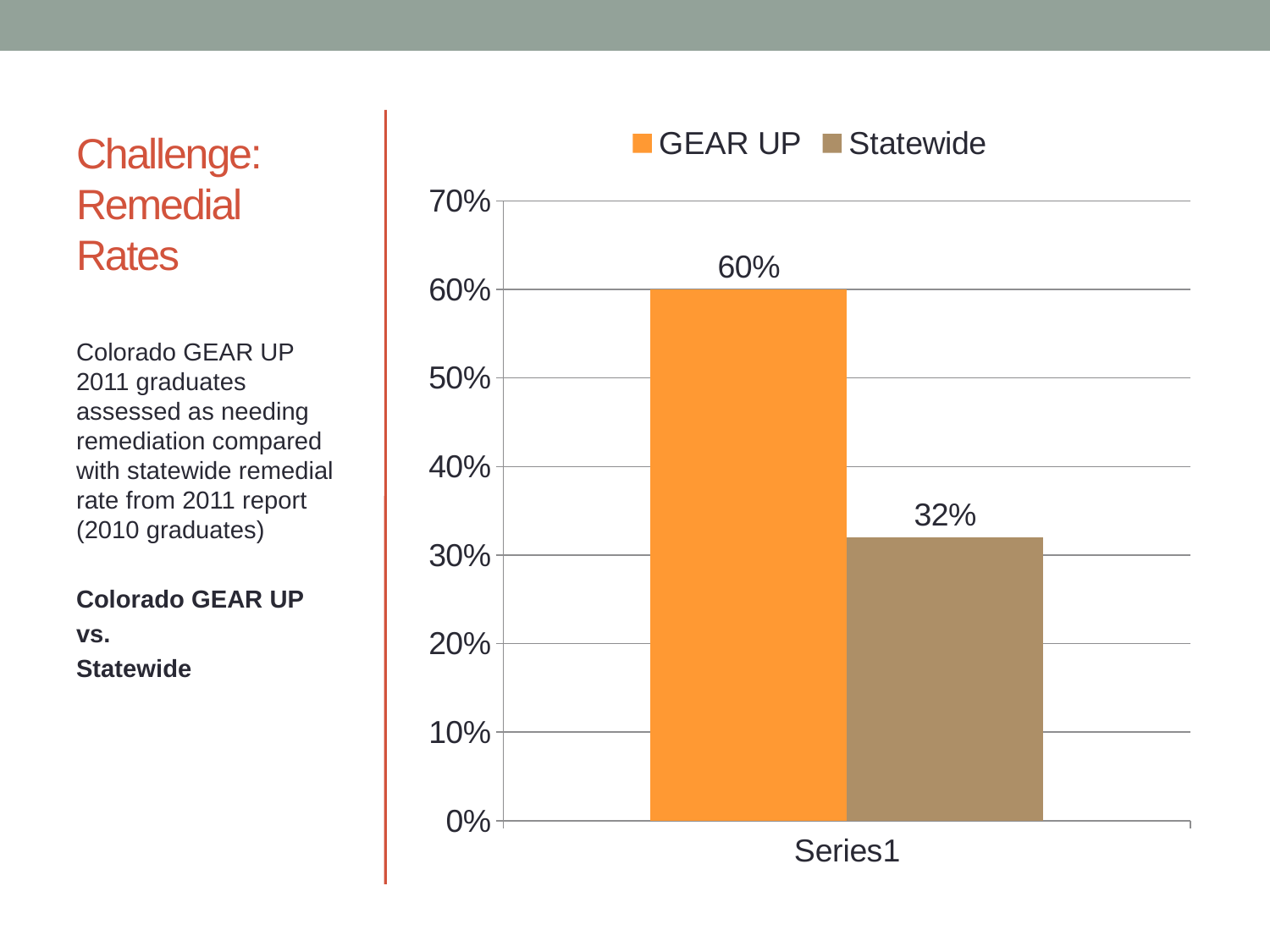
Is the value for Statewide greater or less than 40%? less What is the value for GEAR UP? 60% Which series has the lower value? Statewide How many series does the legend list? 2 What is the value for Statewide? 32% What kind of chart is shown on the slide? bar chart What is the difference between the GEAR UP value and the Statewide value? 28% What colour is the GEAR UP bar? orange What is the highest value shown on the vertical axis? 70% What is the label on the horizontal axis under the bars? Series1 Is the value for GEAR UP greater or less than 50%? greater Which series has the higher value, GEAR UP or Statewide? GEAR UP